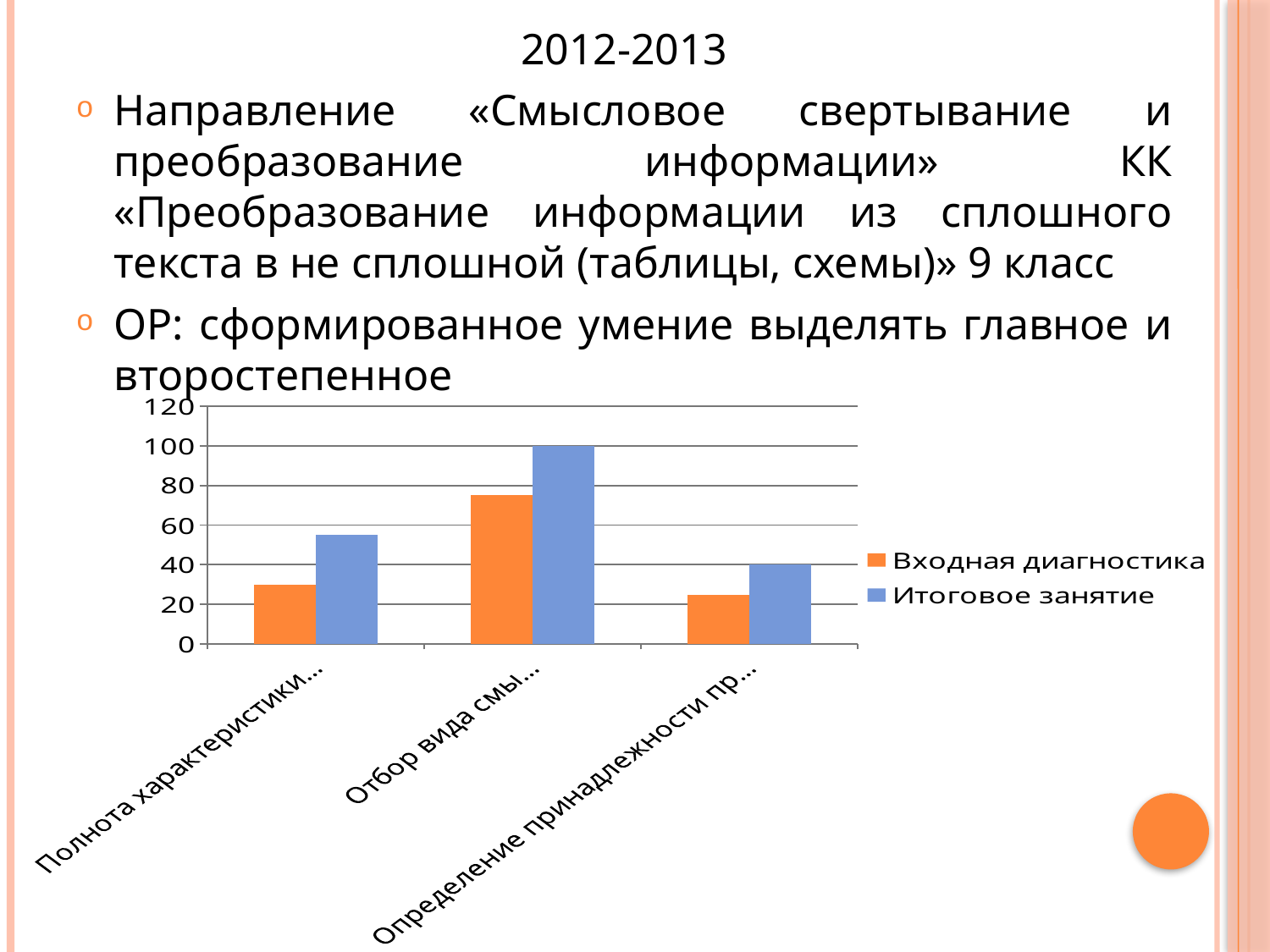
Which category has the lowest value for "Итоговое занятие"? Определение принадлежности пр... Which colour represents the series "Итоговое занятие" in the chart? blue Is the value of "Входная диагностика" for "Отбор вида смы..." greater or less than 60? greater What are the two series named in the chart legend? Входная диагностика, Итоговое занятие How many categories are shown on the x axis of the chart? 3 Which category has the highest value for "Входная диагностика"? Отбор вида смы... What is the value of "Итоговое занятие" for the category "Определение принадлежности пр..."? 40 How many series does the chart legend list? 2 Is the value of "Входная диагностика" for "Полнота характеристики..." greater or less than 40? less What is the value of "Итоговое занятие" for the category "Отбор вида смы..."? 100 What kind of chart is shown on the slide? bar chart For the category "Полнота характеристики...", which series has the larger value, "Входная диагностика" or "Итоговое занятие"? Итоговое занятие